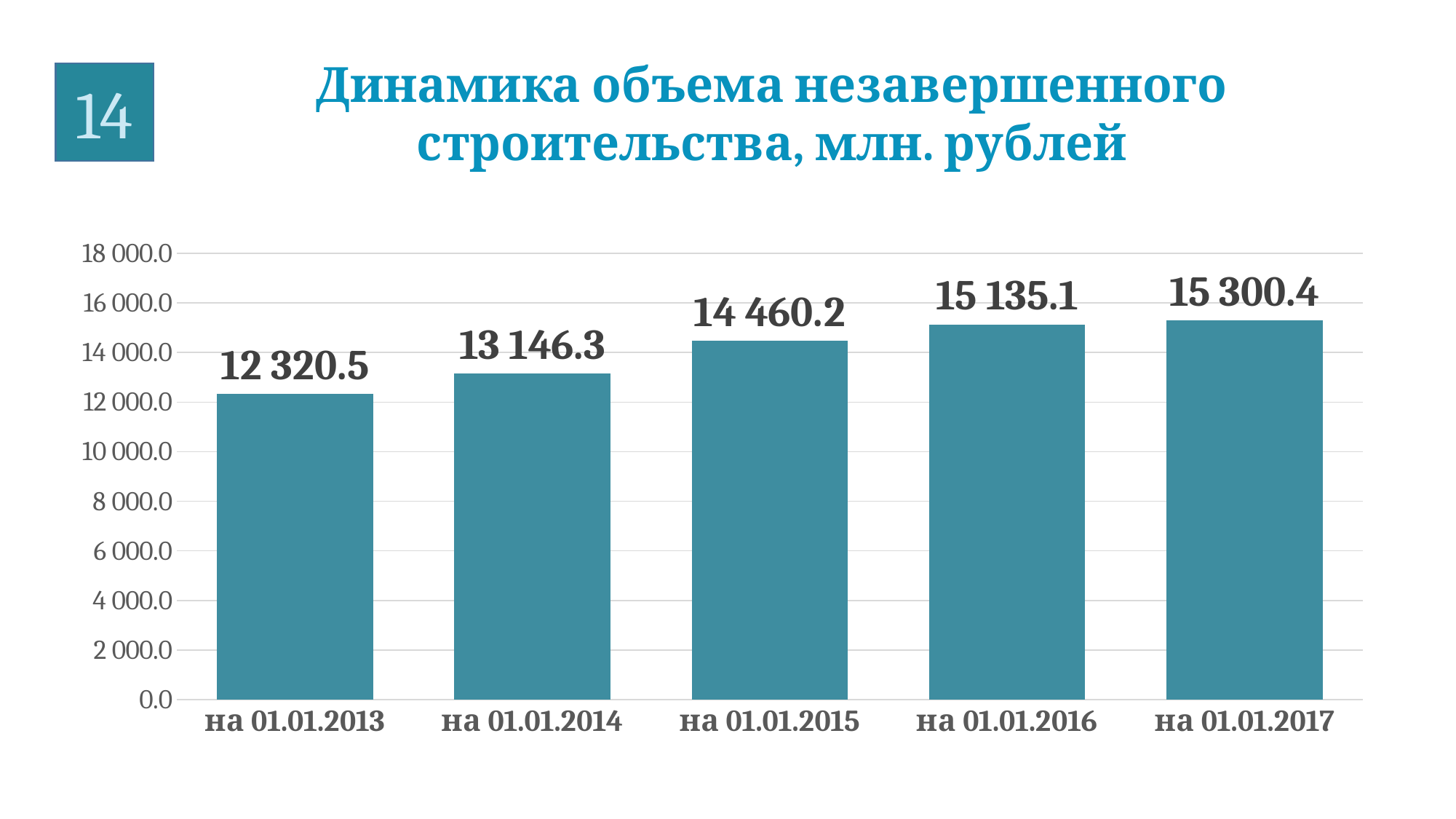
Which is larger, the value for на 01.01.2016 or на 01.01.2015? на 01.01.2016 How many bars are shown in the chart? 5 Which date has the lowest value? на 01.01.2013 Which date has the highest value? на 01.01.2017 What is the difference between the values for на 01.01.2017 and на 01.01.2013? 2 979.9 What kind of chart is shown on the slide? bar chart What is the difference between the values for на 01.01.2014 and на 01.01.2013? 825.8 What is the value for на 01.01.2017? 15 300.4 What is the value for на 01.01.2013? 12 320.5 Do the values rise or fall from на 01.01.2013 to на 01.01.2017? rise What is the value for на 01.01.2015? 14 460.2 Is the value for на 01.01.2014 greater or less than 14 000.0? less